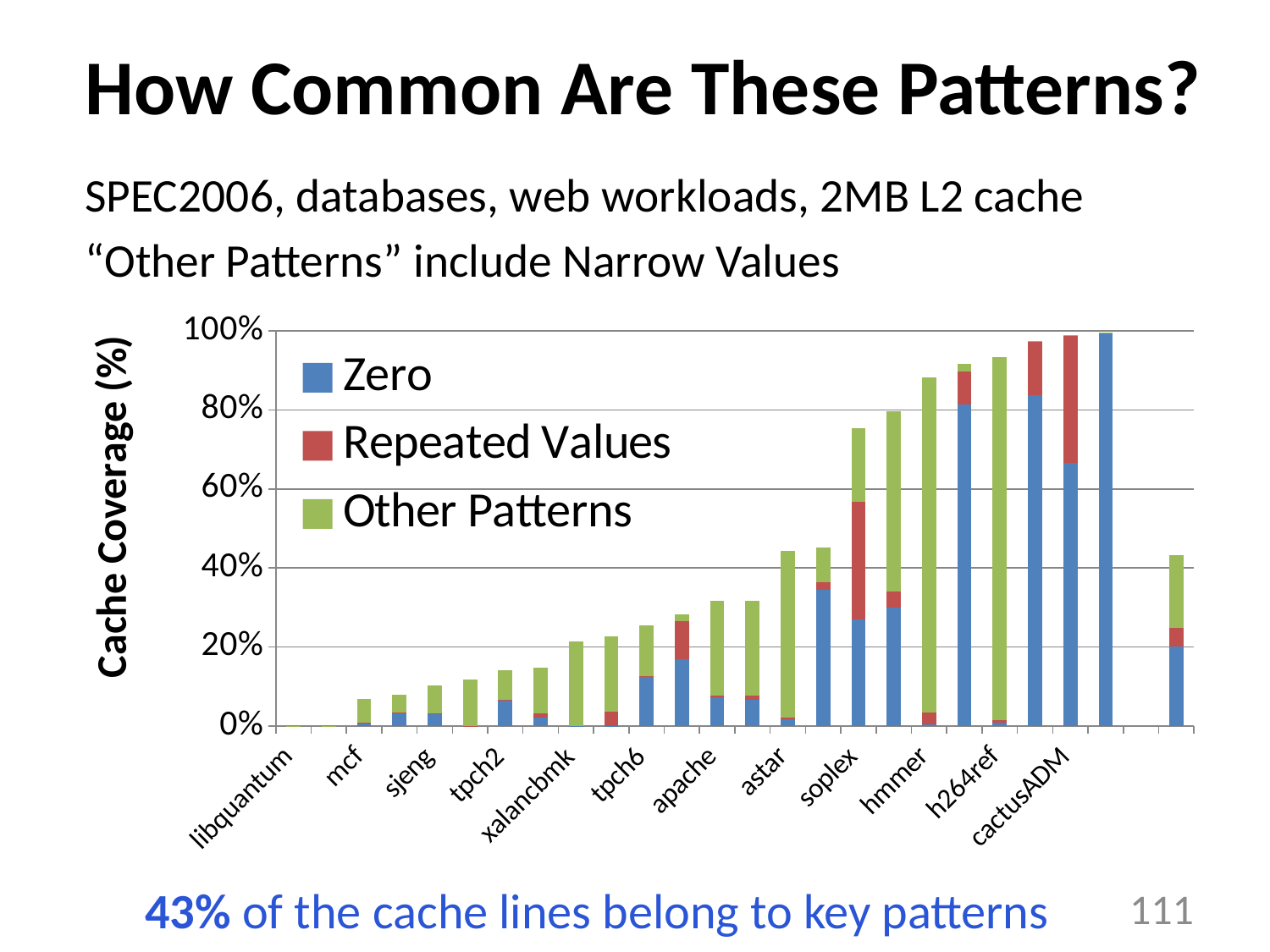
Which has the larger total cache coverage, cactusADM or libquantum? cactusADM Is the total cache coverage for cactusADM greater or less than 80%? greater Is the total cache coverage for mcf greater or less than 20%? less How many series does the chart's legend list? 3 Is the total cache coverage for hmmer greater or less than 60%? greater Do the total bar heights generally rise or fall moving from left to right across the labeled workloads? rise What are the three series named in the chart's legend? Zero, Repeated Values, Other Patterns What kind of chart is shown on the slide? Stacked bar chart What is the label on the chart's vertical axis? Cache Coverage (%)